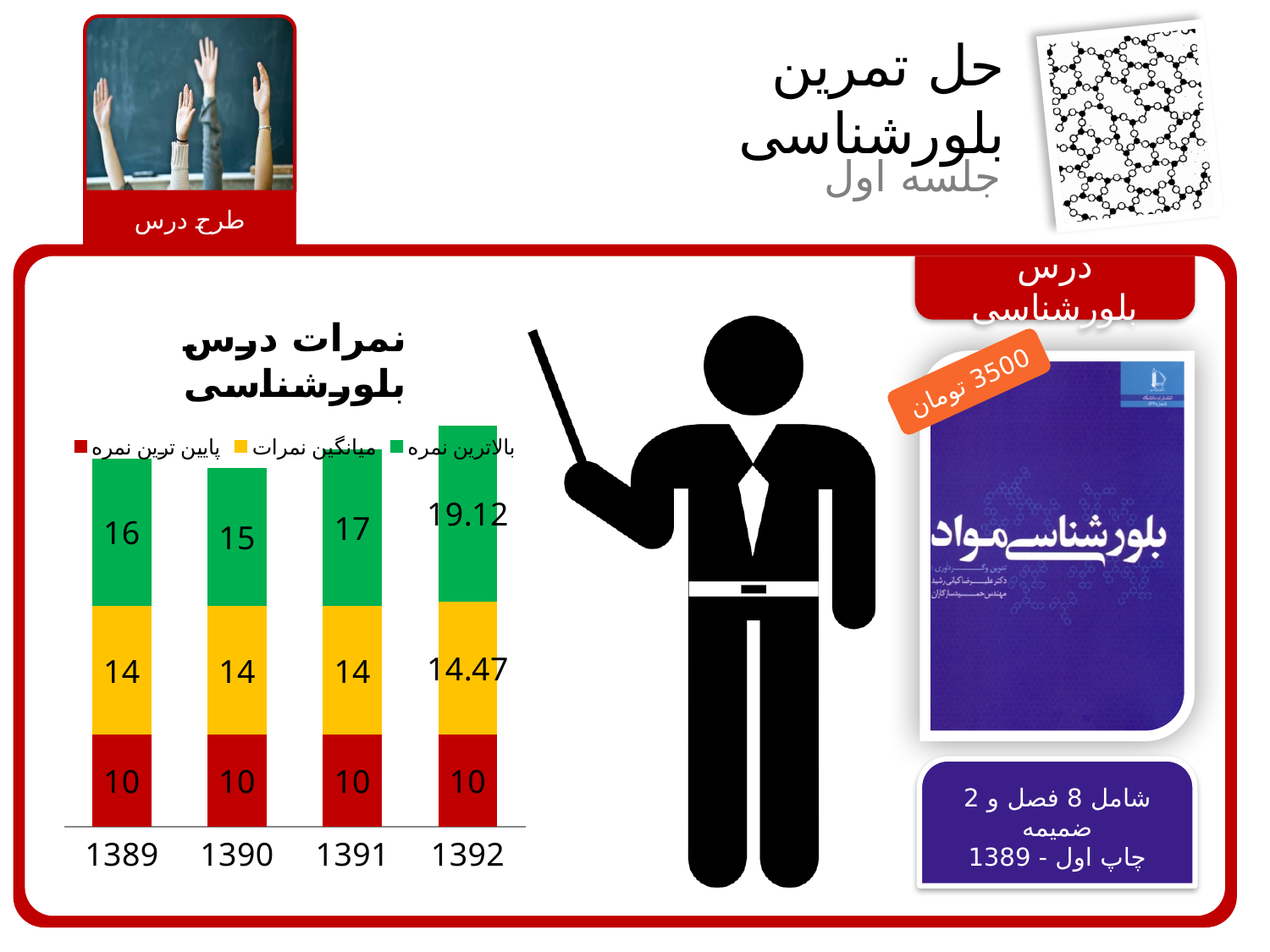
Which year has the highest value for بالاترین نمره? 1392 What is the total of the stacked bar for 1389? 40 What is the value of پایین ترین نمره for 1391? 10 What type of chart is shown on the slide? stacked bar chart Which year has the lowest value for بالاترین نمره? 1390 What is the value of بالاترین نمره for 1390? 15 What is the value of بالاترین نمره for 1392? 19.12 What is the difference between the بالاترین نمره values for 1392 and 1391? 2.12 How many series does the chart legend list? 3 What is the value of میانگین نمرات for 1392? 14.47 Which is larger, the بالاترین نمره value for 1389 or for 1391? 1391 How many years are shown on the x axis of the chart? 4